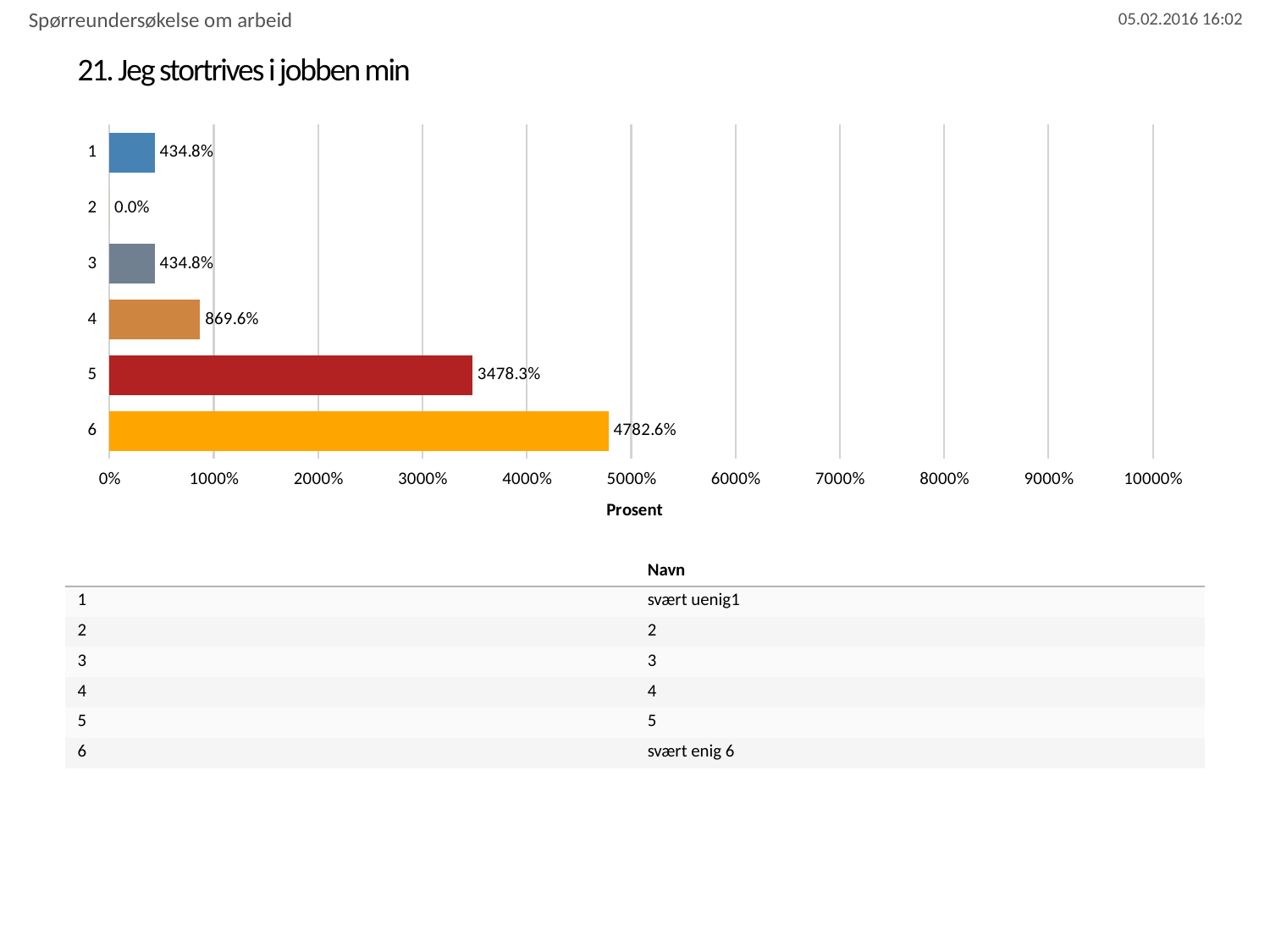
What is the value for category 5? 3478.3% What kind of chart is shown on the slide? bar chart Which category has the highest value? 6 What is the value for category 6? 4782.6% How many categories are shown in the chart? 6 What is the value for category 4? 869.6% Is the value for category 5 greater or less than 3000%? greater Which is larger, the value for category 4 or the value for category 3? 4 What is the value for category 2? 0.0% What is the title of the chart? 21. Jeg stortrives i jobben min What is the difference between the values for category 6 and category 5? 1304.3% Which category has the lowest value? 2